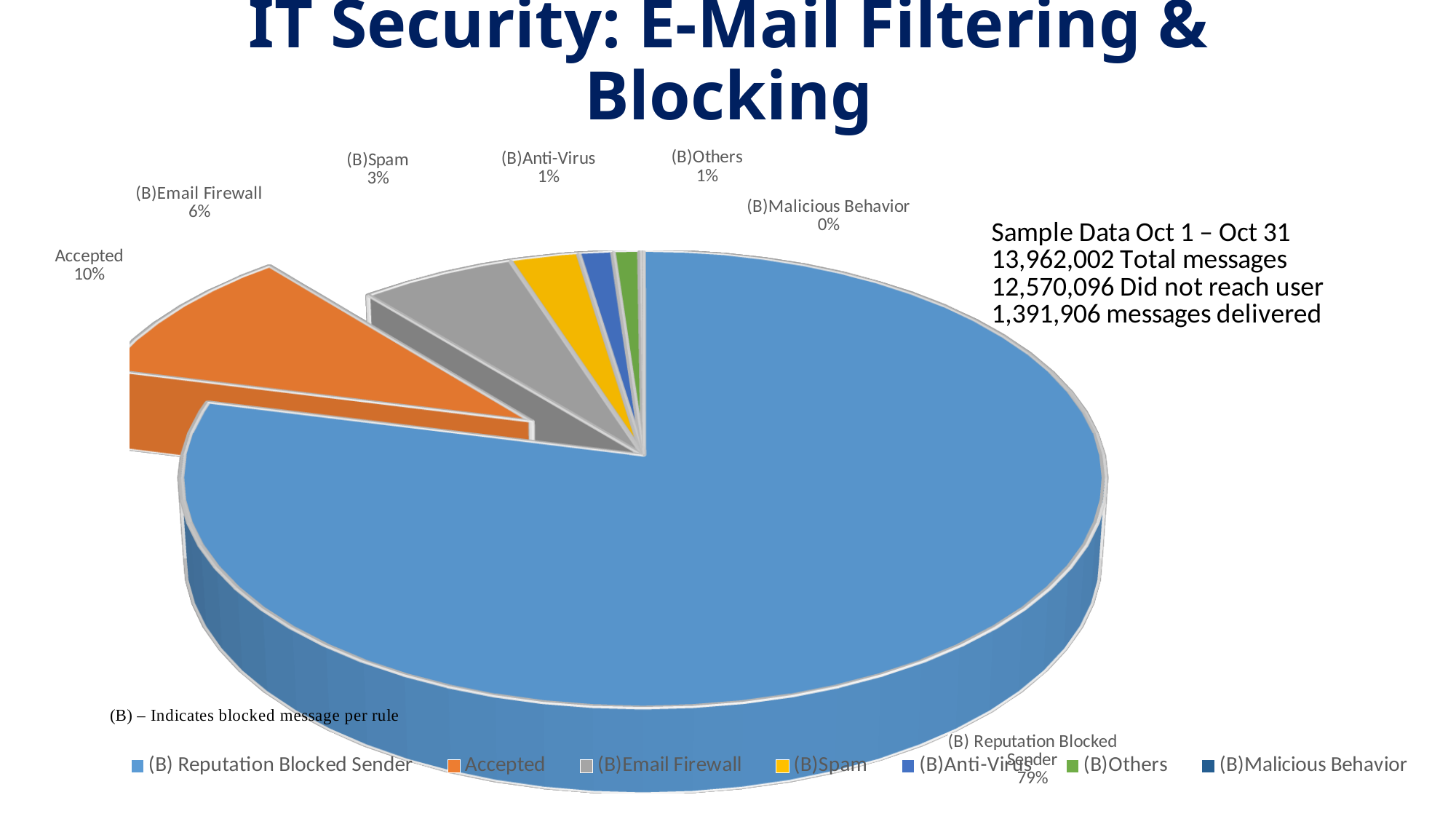
What share of the pie does (B) Reputation Blocked Sender have? 79% What percentage is shown for Accepted? 10% Which category has the largest slice of the pie? (B) Reputation Blocked Sender What kind of chart is shown on the slide? pie chart What percentage is shown for (B)Email Firewall? 6% Which is larger, the slice for (B)Spam or the slice for (B)Email Firewall? (B)Email Firewall Which category has the smallest slice of the pie? (B)Malicious Behavior What is the difference in percentage points between Accepted and (B)Email Firewall? 4 How many entries does the legend list? 7 What percentage is shown for (B)Spam? 3% What colour is the Accepted slice? orange What percentage is shown for (B)Malicious Behavior? 0%